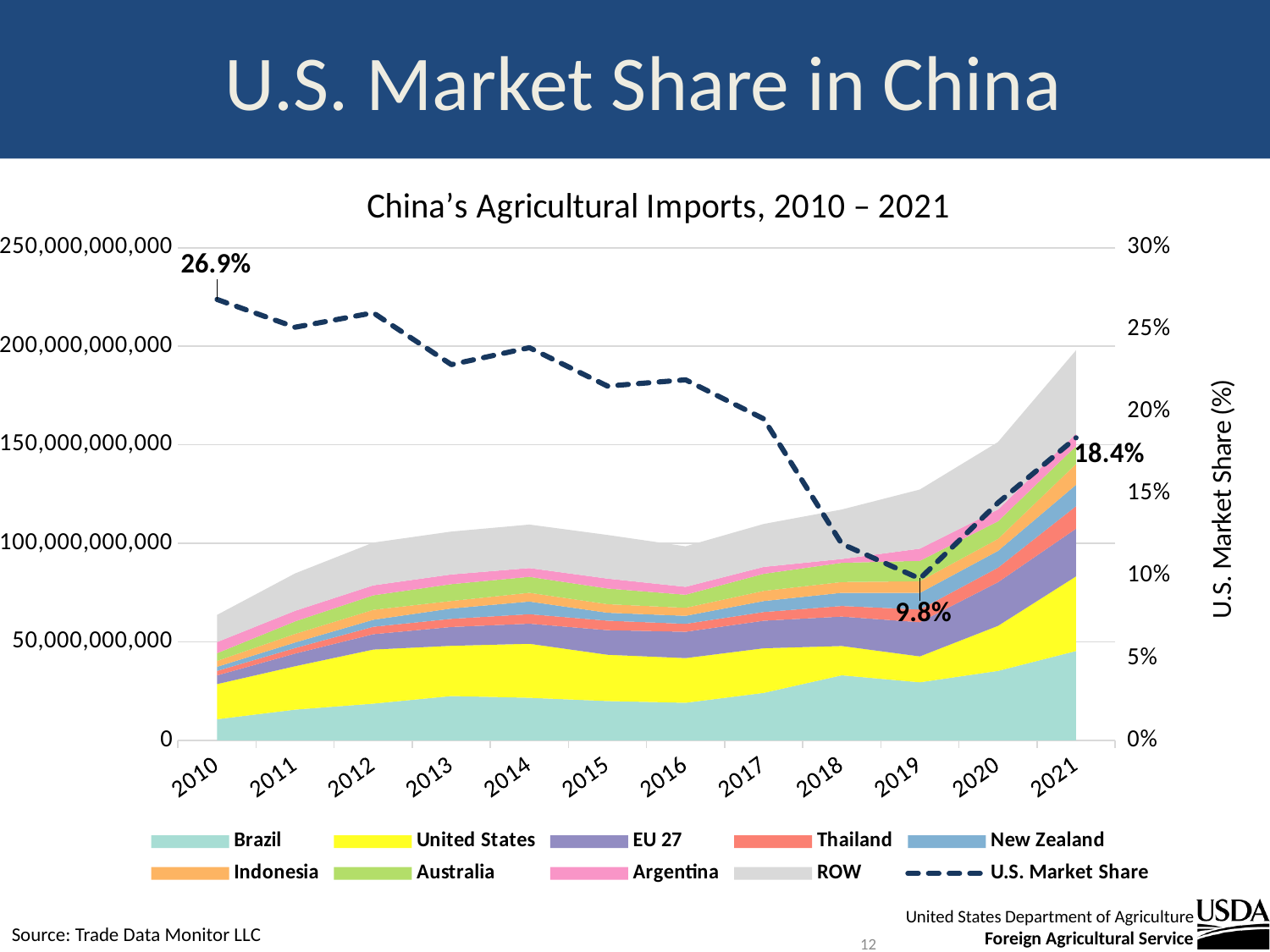
By how many percentage points did the U.S. market share fall from 2010 to 2019? 17.1 percentage points What is the title of the chart? China's Agricultural Imports, 2010 – 2021 How many series does the legend list? 10 By how many percentage points did the U.S. market share rise from 2019 to 2021? 8.6 percentage points What kind of chart is this? Stacked area chart with a line What was the U.S. market share in China in 2010? 26.9% What was the U.S. market share in China in 2021? 18.4% Is the total of China's agricultural imports in 2021 greater or less than 150,000,000,000? greater How many years are shown on the x axis? 12 In which year was the U.S. market share line at its lowest? 2019 What was the U.S. market share in China in 2019? 9.8% In which year was the U.S. market share line at its highest? 2010